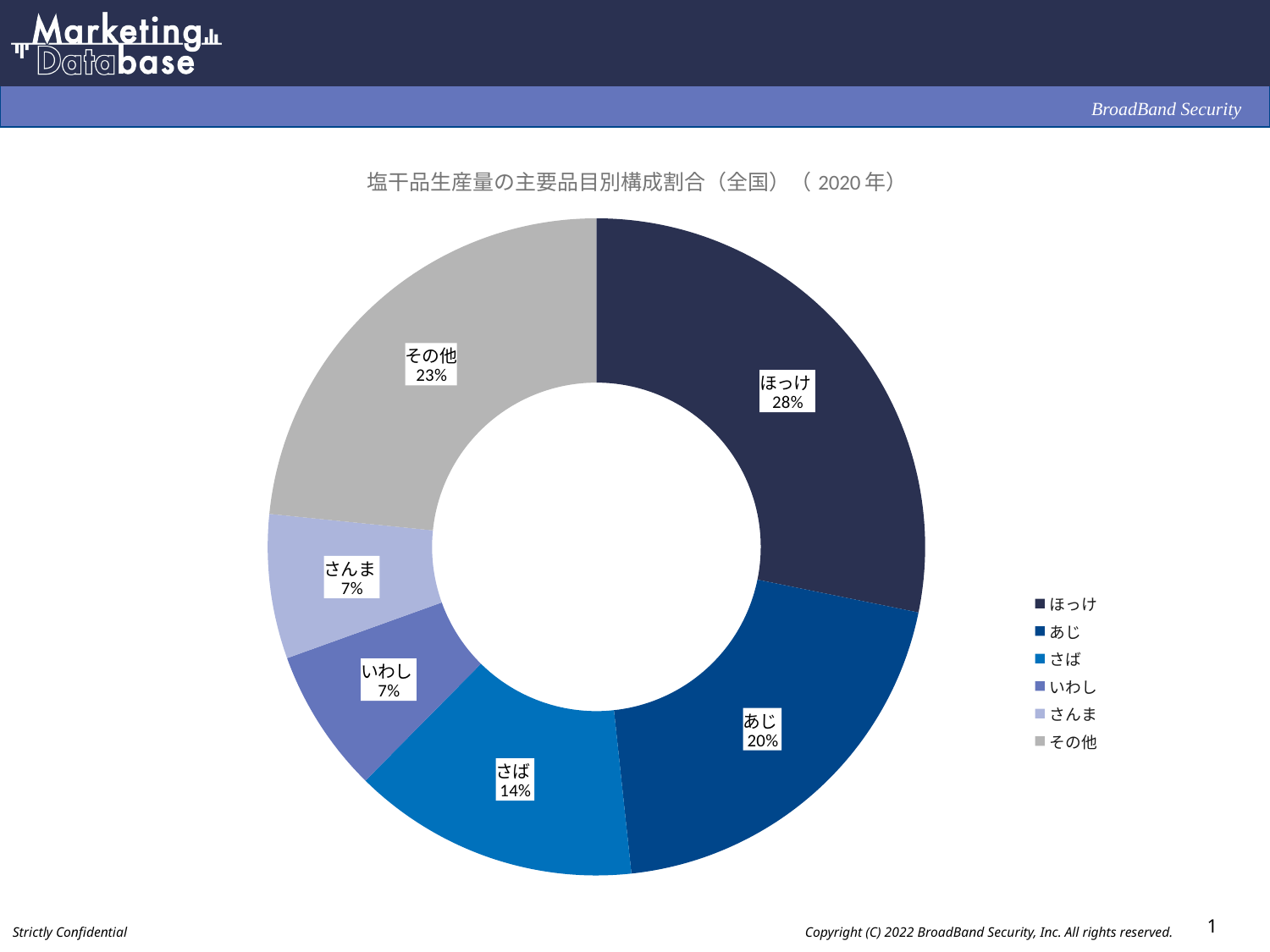
What kind of chart is shown on the slide? Pie chart (doughnut) What is the share for ほっけ? 28% What is the share for さば? 14% What is the share for その他? 23% What is the share for さんま? 7% Which is larger, the share for その他 or the share for あじ? その他 Which category has the largest share? ほっけ What is the share for あじ? 20% How many entries does the legend list? 6 What is the difference in percentage points between ほっけ and あじ? 8 percentage points How many categories does the chart show? 6 What is the title of the chart? 塩干品生産量の主要品目別構成割合（全国）（2020年）